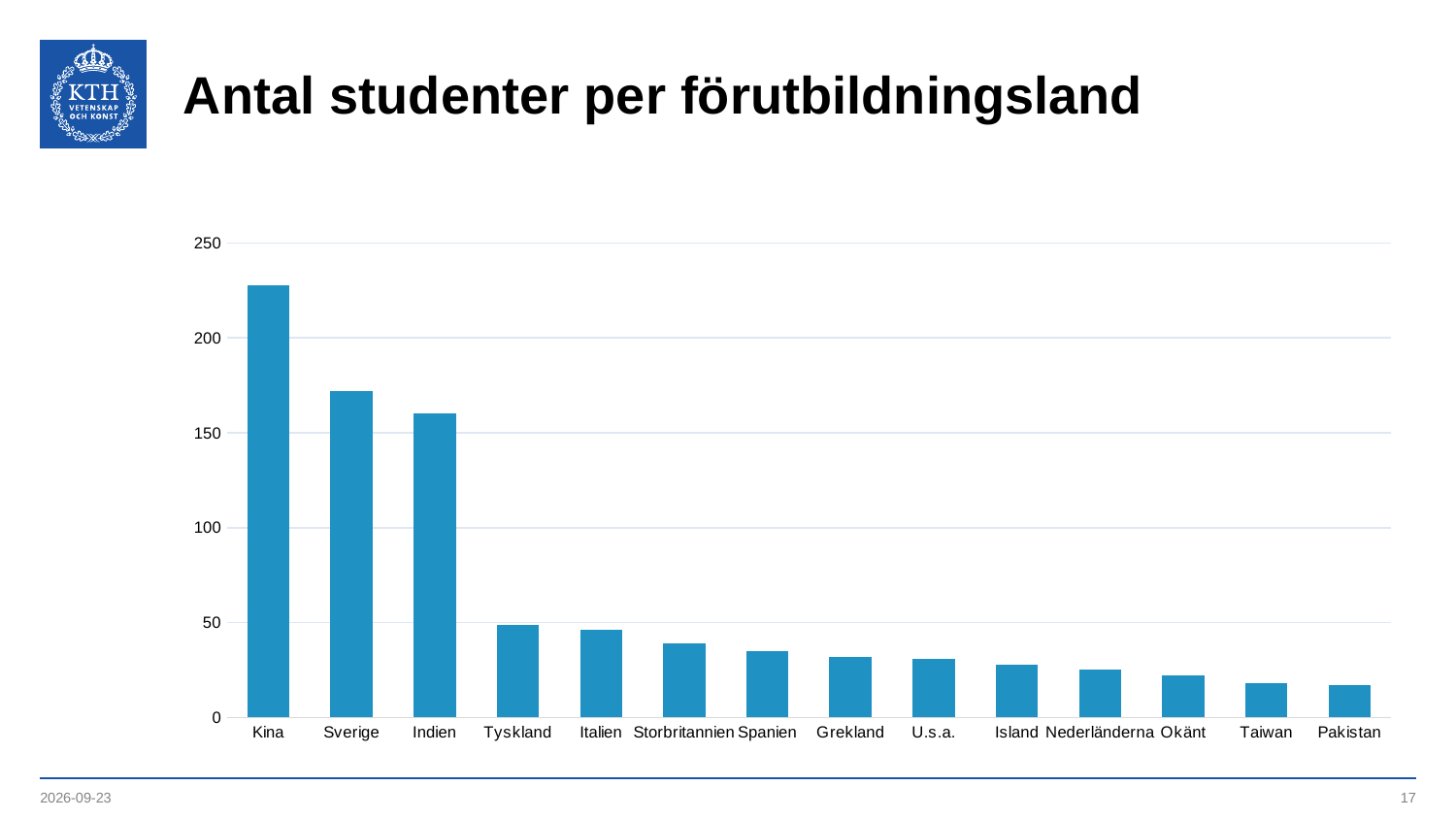
Which country has the highest number of students? Kina What kind of chart is shown on the slide? bar chart How many countries (categories) are shown on the x axis? 14 Is the value for Storbritannien greater or less than 50? less Do the values rise or fall from left to right along the x axis? fall Is the value for Kina greater or less than 200? greater Is the value for Pakistan greater or less than 50? less Which has more students, Kina or Sverige? Kina What is the title of the slide's chart? Antal studenter per förutbildningsland